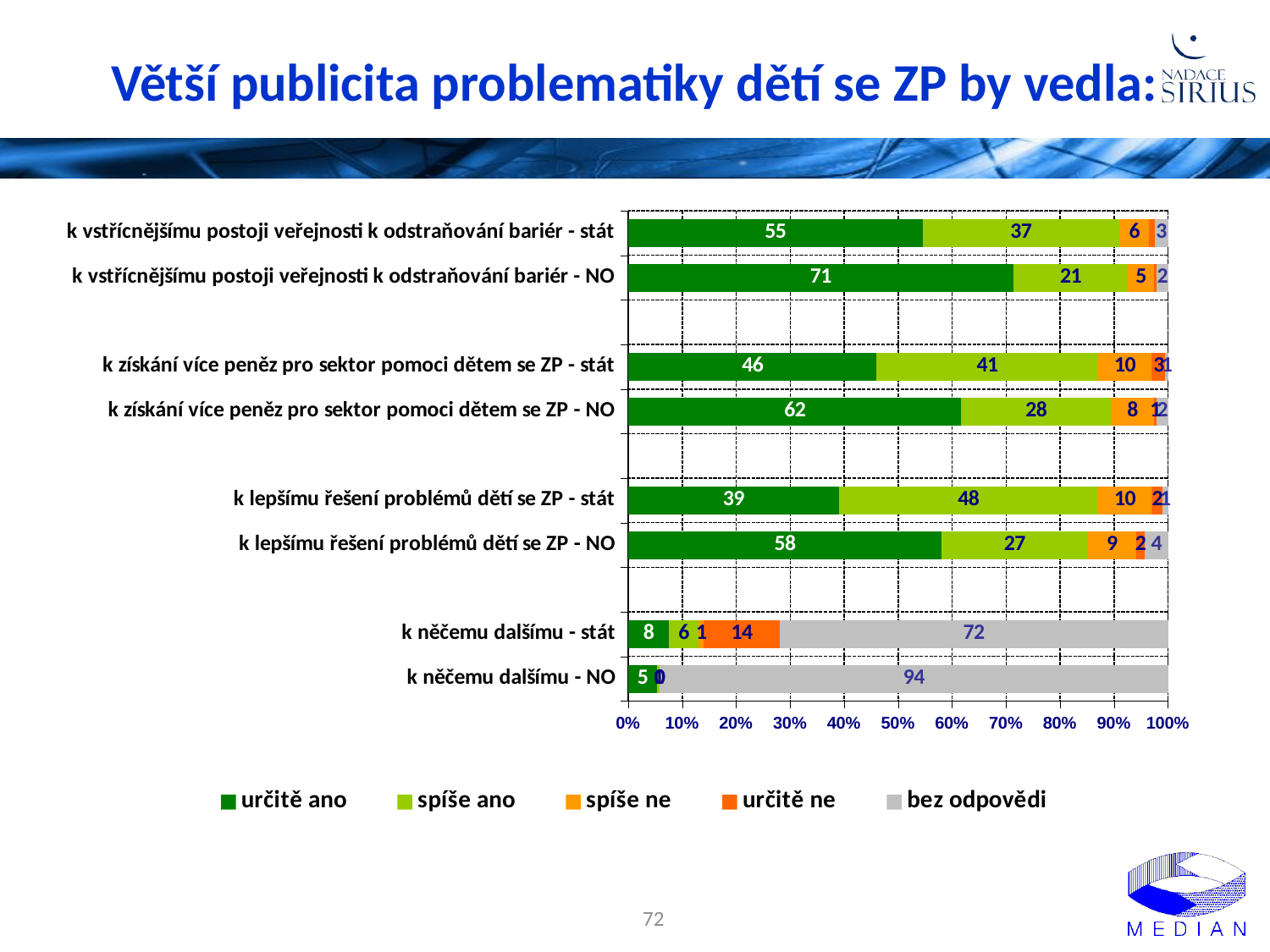
What is the 'spíše ano' value for 'k lepšímu řešení problémů dětí se ZP - stát'? 48 What is the difference in 'určitě ano' between 'k vstřícnějšímu postoji veřejnosti k odstraňování bariér - NO' and 'k vstřícnějšímu postoji veřejnosti k odstraňování bariér - stát'? 16 What is the 'bez odpovědi' value for 'k něčemu dalšímu - NO'? 94 How many series does the legend list? 5 What kind of chart is shown on the slide? bar chart Which has the larger 'spíše ano' value: 'k získání více peněz pro sektor pomoci dětem se ZP - stát' or 'k získání více peněz pro sektor pomoci dětem se ZP - NO'? k získání více peněz pro sektor pomoci dětem se ZP - stát How many categories (bars) are plotted in the chart? 8 Which category has the lowest 'určitě ano' value? k něčemu dalšímu - NO What is the 'spíše ne' value for 'k získání více peněz pro sektor pomoci dětem se ZP - stát'? 10 Which series is shown in dark green in the legend? určitě ano Which category has the highest 'určitě ano' value? k vstřícnějšímu postoji veřejnosti k odstraňování bariér - NO What is the 'určitě ano' value for 'k vstřícnějšímu postoji veřejnosti k odstraňování bariér - NO'? 71